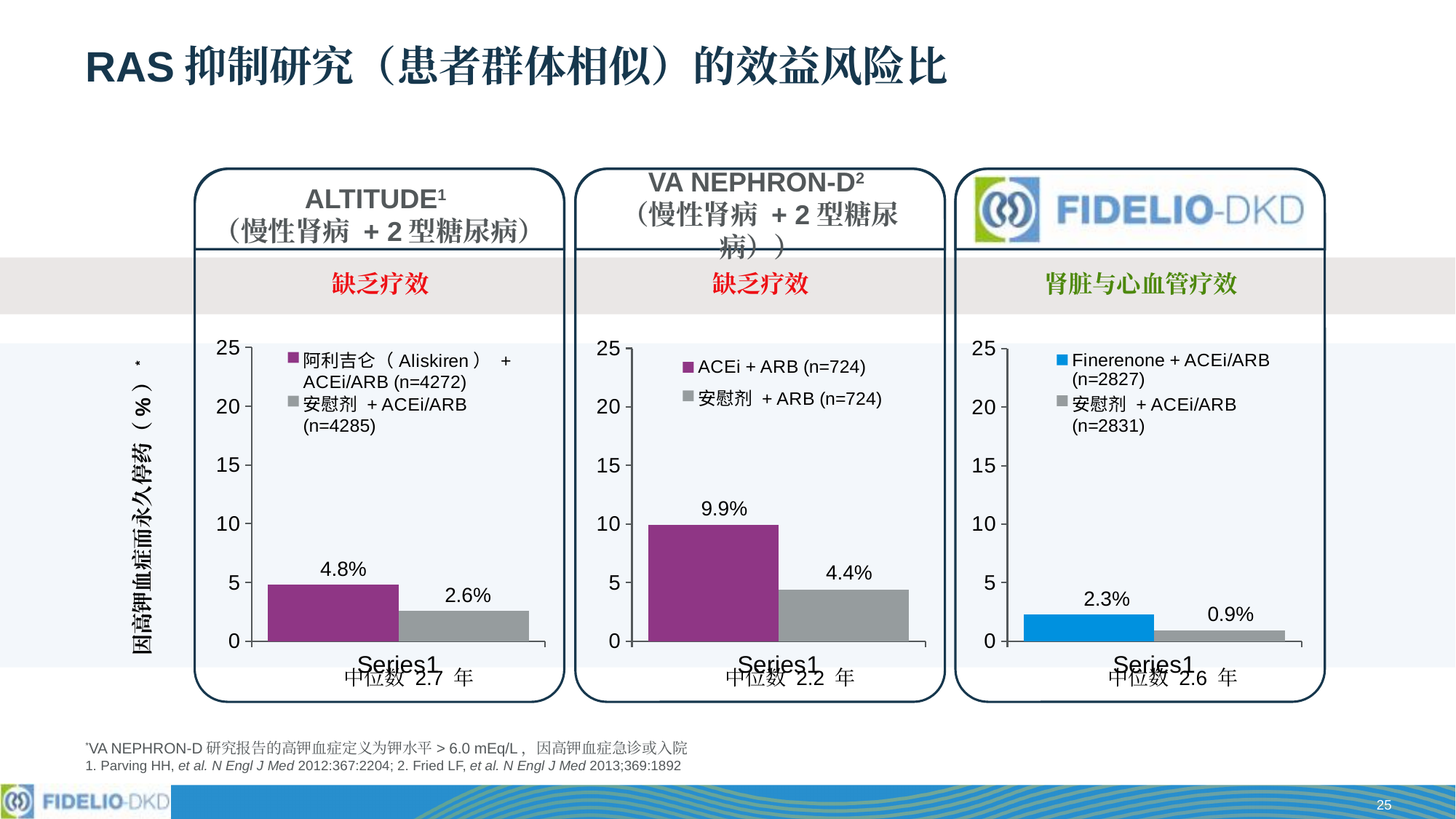
In the VA NEPHRON-D chart in the middle, what is the difference between the ACEi + ARB value and the 安慰剂 + ARB value? 5.5% In the ALTITUDE chart on the left, what is the value for 安慰剂 + ACEi/ARB? 2.6% In the ALTITUDE chart on the left, what is the value for 阿利吉仑 (Aliskiren) + ACEi/ARB? 4.8% In the ALTITUDE chart on the left, which series has the higher value? 阿利吉仑 (Aliskiren) + ACEi/ARB What kind of chart is the ALTITUDE chart on the left? bar chart In the VA NEPHRON-D chart in the middle, is the value for ACEi + ARB greater or less than 5? greater In the FIDELIO-DKD chart on the right, what is the value for 安慰剂 + ACEi/ARB? 0.9% In the VA NEPHRON-D chart in the middle, what is the value for 安慰剂 + ARB? 4.4% In the FIDELIO-DKD chart on the right, what is the difference between the Finerenone + ACEi/ARB value and the 安慰剂 + ACEi/ARB value? 1.4% In the FIDELIO-DKD chart on the right, what is the value for Finerenone + ACEi/ARB? 2.3% In the VA NEPHRON-D chart in the middle, what is the value for ACEi + ARB? 9.9% How many series does the legend of the FIDELIO-DKD chart on the right list? 2